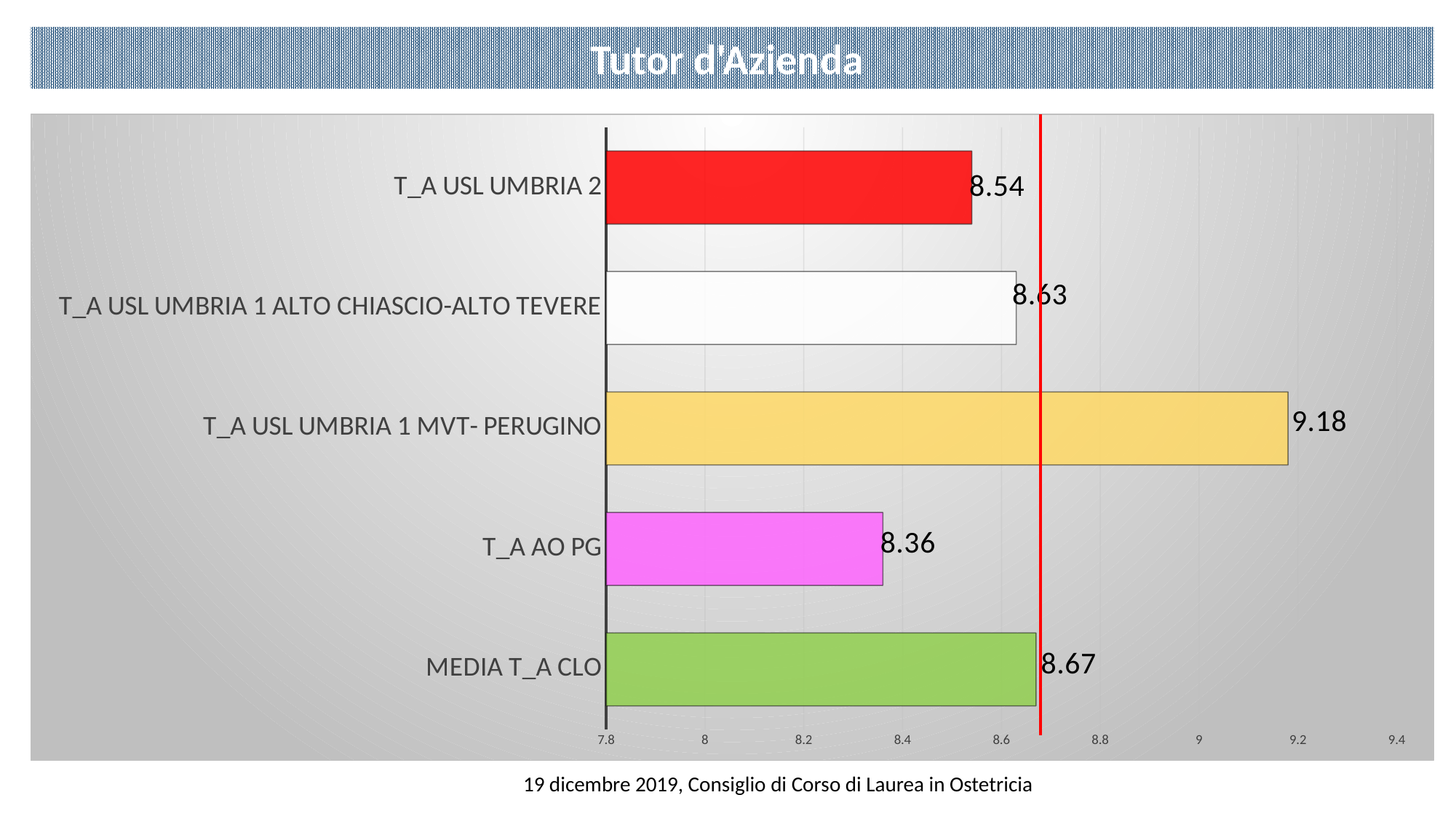
What kind of chart is shown on the slide? bar chart Is the value for T_A USL UMBRIA 1 MVT- PERUGINO greater or less than 9? greater Which category has the highest value? T_A USL UMBRIA 1 MVT- PERUGINO What is the value for T_A USL UMBRIA 2? 8.54 What is the value for MEDIA T_A CLO? 8.67 How many categories are shown in the chart? 5 What is the value for T_A USL UMBRIA 1 ALTO CHIASCIO-ALTO TEVERE? 8.63 Which is larger, the value for T_A USL UMBRIA 2 or the value for T_A USL UMBRIA 1 ALTO CHIASCIO-ALTO TEVERE? T_A USL UMBRIA 1 ALTO CHIASCIO-ALTO TEVERE What is the difference between the values for T_A USL UMBRIA 1 MVT- PERUGINO and T_A AO PG? 0.82 What is the value for T_A AO PG? 8.36 What is the title of the slide? Tutor d'Azienda Which category has the lowest value? T_A AO PG